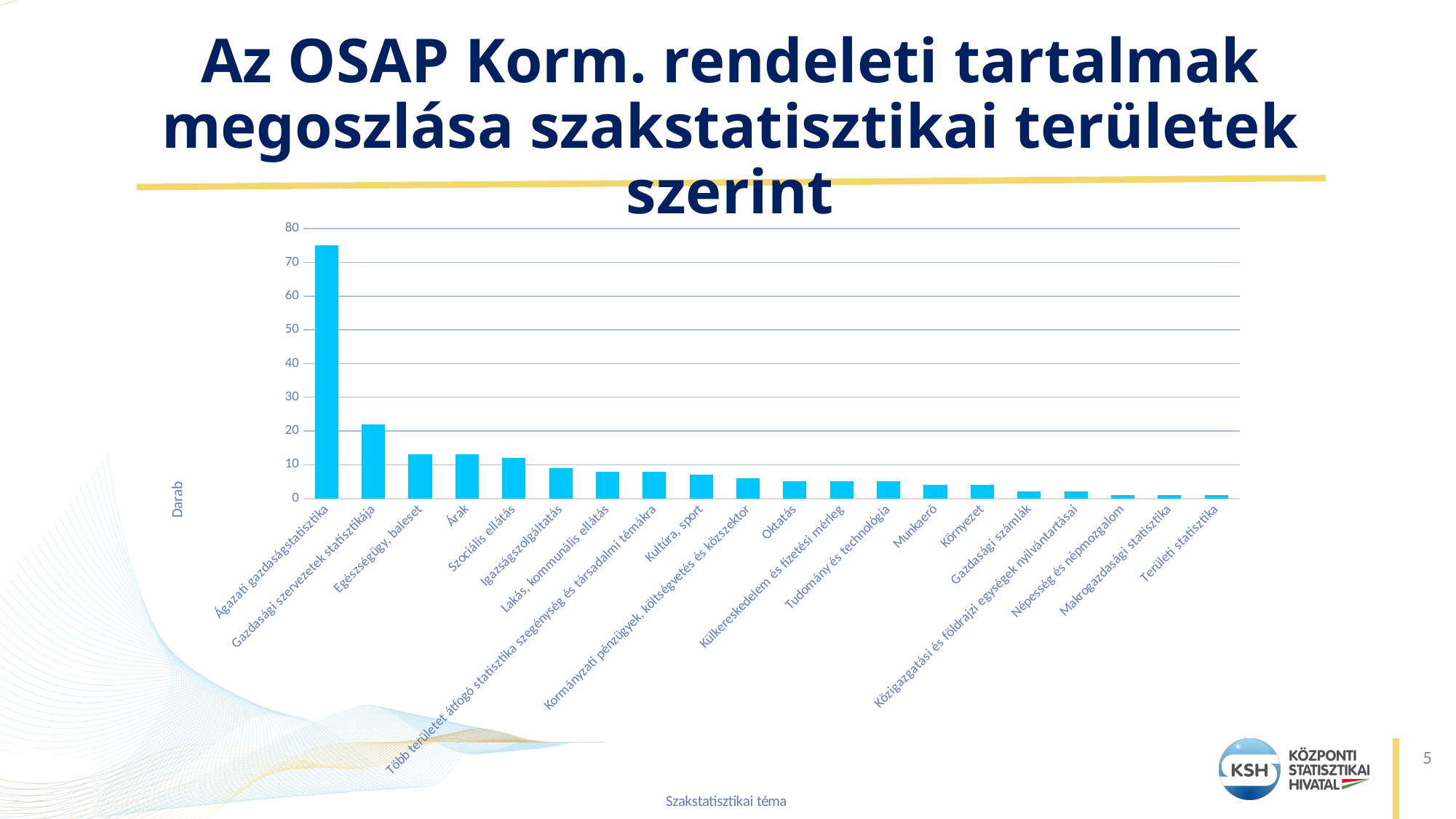
Is the value for Egészségügy, baleset greater or less than 10? greater Is the value for Gazdasági szervezetek statisztikája greater or less than 20? greater What kind of chart is shown on the slide? bar chart Which is larger, the value for Gazdasági szervezetek statisztikája or the value for Kultúra, sport? Gazdasági szervezetek statisztikája How many categories (bars) are shown in the chart? 20 Which is larger, the value for Szociális ellátás or the value for Munkaerő? Szociális ellátás Which category has the highest value in the chart? Ágazati gazdaságstatisztika Is the value for Oktatás greater or less than 10? less Do the bar values rise or fall from left to right along the x axis? fall What is the label of the vertical axis of the chart? Darab